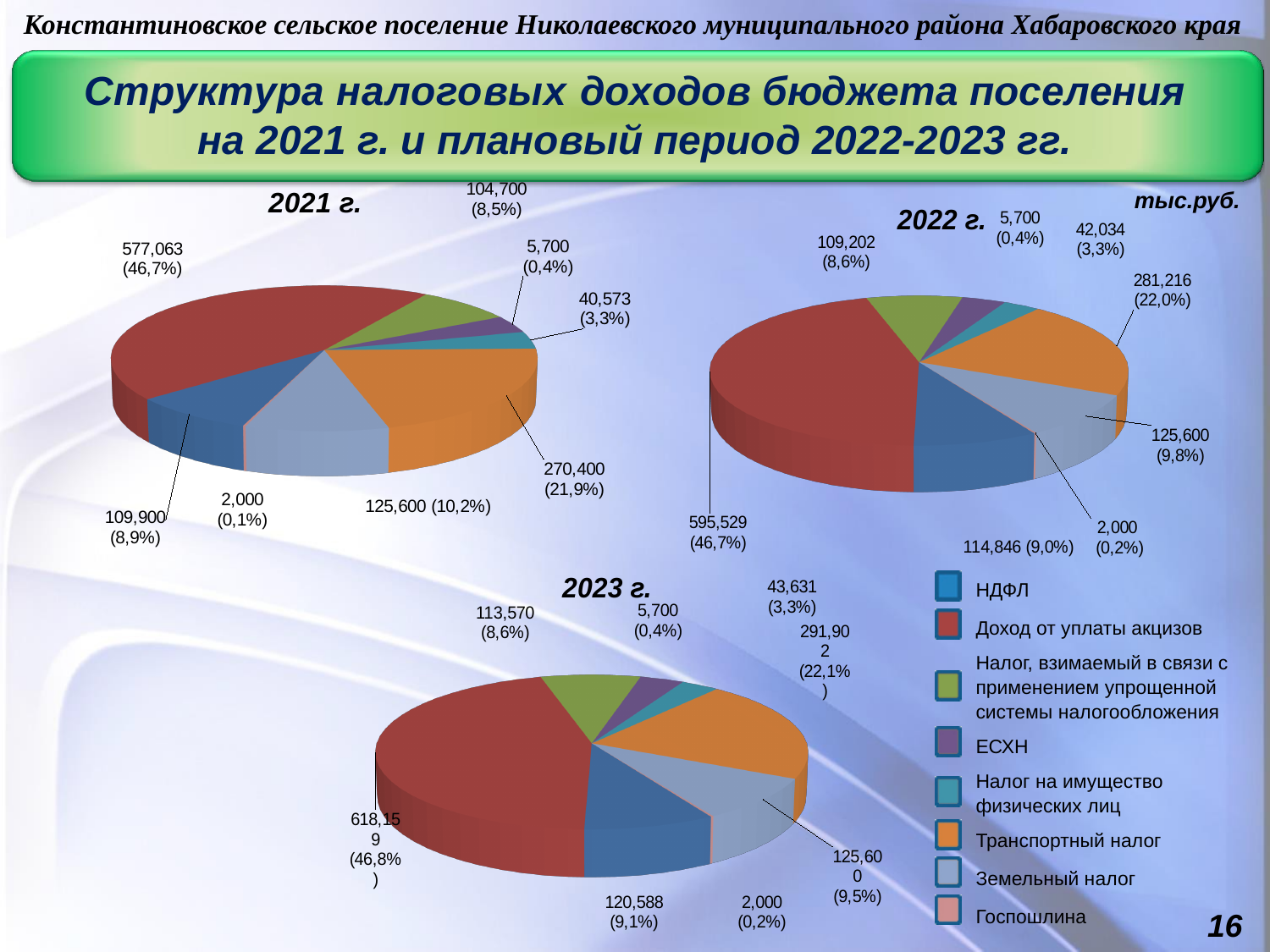
In the 2021 г. chart, which is larger: the slice valued 270,400 or the slice valued 125,600? 270,400 Which legend entry corresponds to the red colour? Доход от уплаты акцизов In the 2021 г. chart, how many slices does the pie have? 8 What unit of measurement is indicated for the charts? тыс.руб. In the 2022 г. chart, what is the value of the largest slice? 595,529 In the 2021 г. chart, what is the share of the largest slice? 46,7% In the 2021 г. chart, what share does the slice valued 104,700 have? 8,5% What kind of charts are shown on the slide? Pie charts What is the difference between the largest slice in the 2022 г. chart (595,529) and the largest slice in the 2021 г. chart (577,063)? 18,466 How many entries does the legend list? 8 In the 2023 г. chart, what is the value of the slice labelled 22,1%? 291,902 In the 2022 г. chart, what is the share of the smallest slice? 0,2%